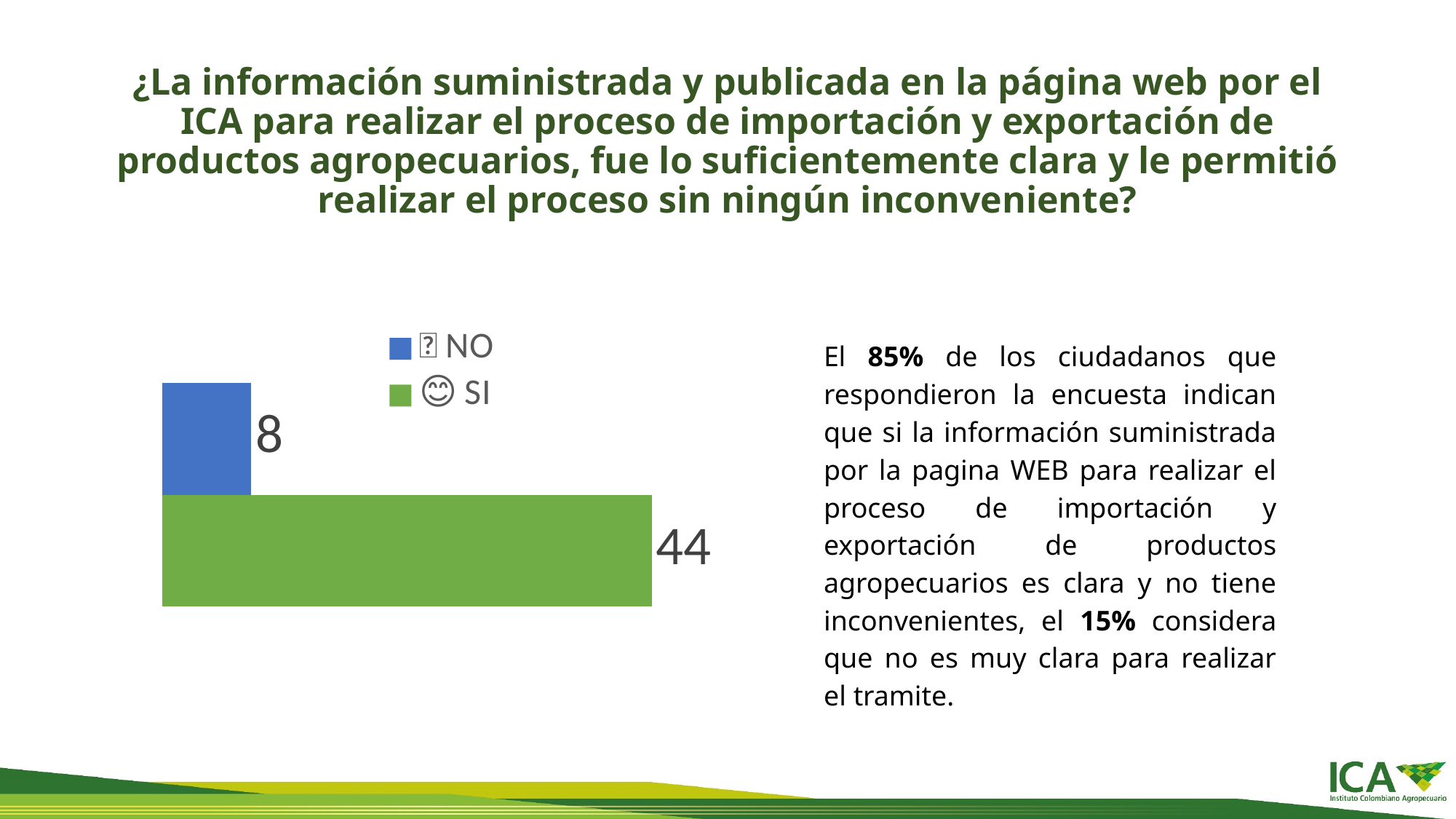
What is the difference between the values for SI and NO? 36 Which category has the highest value in the chart? SI What is the value for NO in the chart? 8 What colour is the bar for NO? Blue What colour is the bar for SI? Green Which is larger, the value for SI or the value for NO? SI How many entries does the chart legend list? 2 What is the value for SI in the chart? 44 Which category has the lowest value in the chart? NO What is the total of the values for SI and NO? 52 How many categories are shown in the chart? 2 What kind of chart is shown on the slide? Bar chart